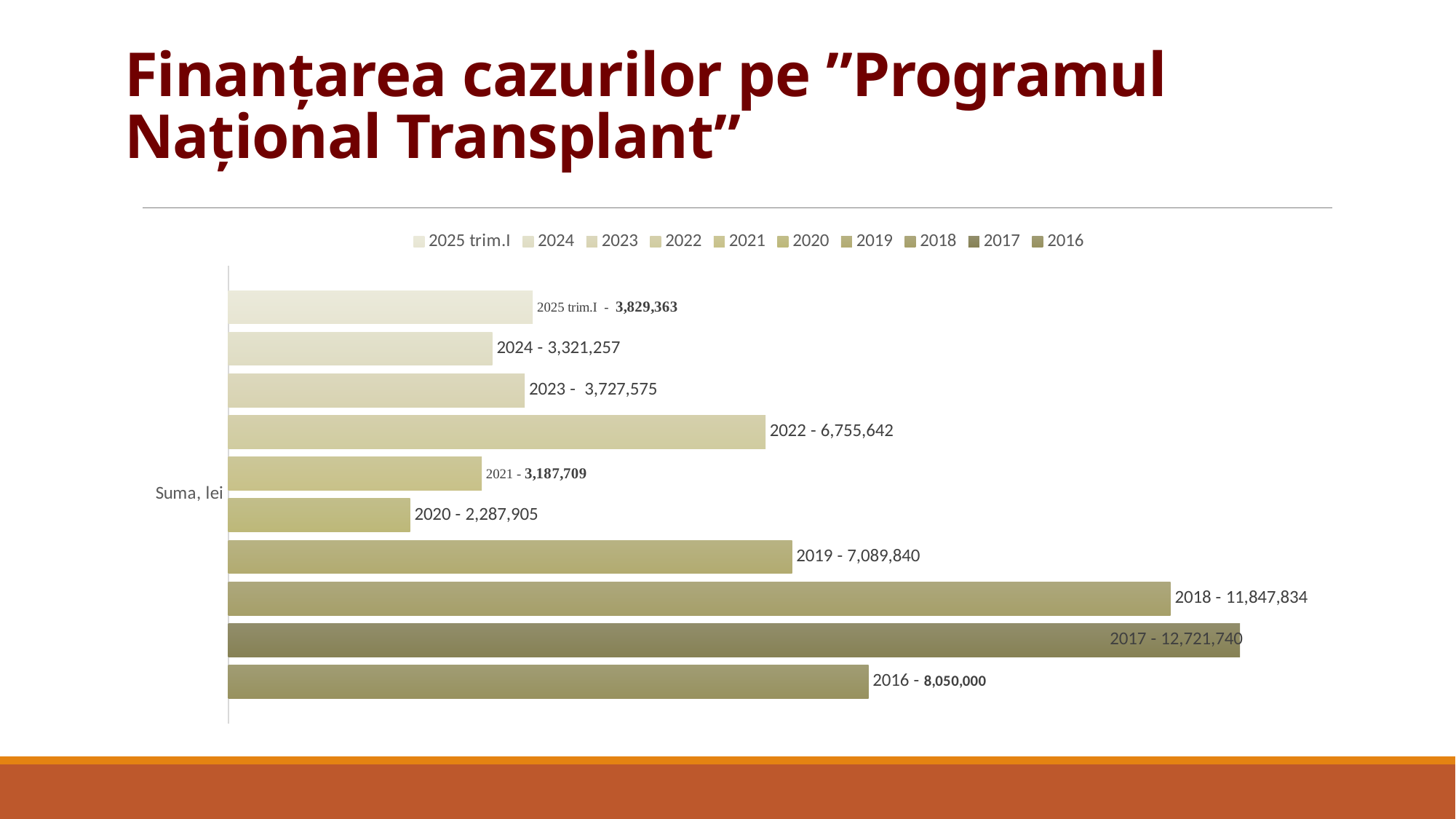
What is the difference between the values for 2019 and 2022? 334,198 What is the difference between the values for 2017 and 2018? 873,906 What kind of chart is shown on the slide? Bar chart How many series does the legend list? 10 Which year has the lowest value? 2020 What is the value shown for 2017? 12,721,740 What is the value shown for 2025 trim.I? 3,829,363 Which is larger, the value for 2016 or the value for 2019? 2016 What is the value shown for 2020? 2,287,905 Which year has the highest value? 2017 How many bars are plotted in the chart? 10 What is the value shown for 2022? 6,755,642